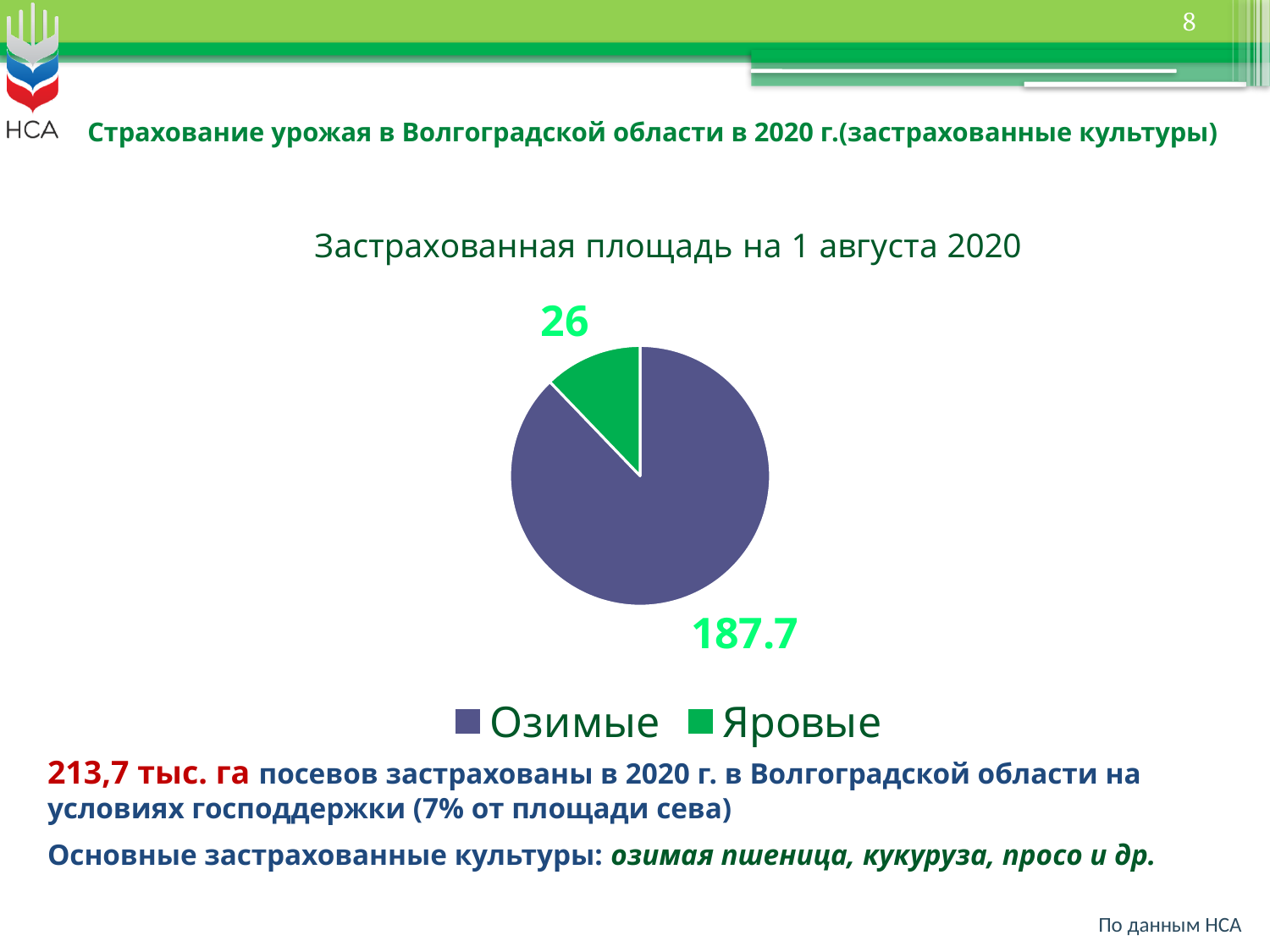
Which category has the smallest slice in the pie chart? Яровые What colour is the Яровые slice in the pie chart? green How many entries does the legend list? 2 What is the value for Озимые in the pie chart? 187.7 How many slices does the pie chart have? 2 What is the total of the two slices in the pie chart? 213.7 What is the title of the chart? Застрахованная площадь на 1 августа 2020 Which category has the largest slice in the pie chart? Озимые Which is larger, the value for Озимые or the value for Яровые? Озимые What is the value for Яровые in the pie chart? 26 What is the difference between the values for Озимые and Яровые? 161.7 What kind of chart is shown on the slide? pie chart